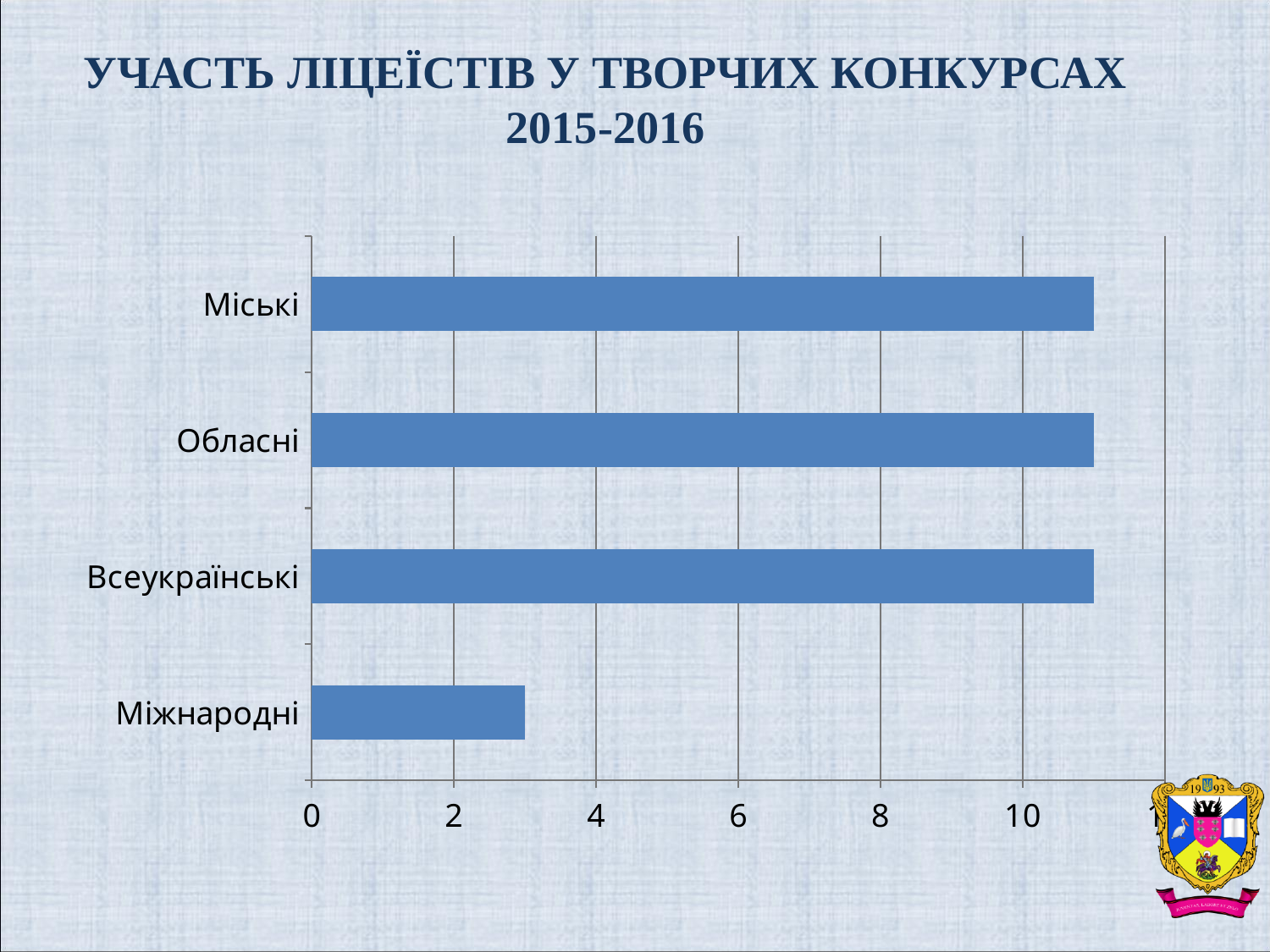
Which is larger, the value for Міські or the value for Міжнародні? Міські Which category has the lowest value in the chart? Міжнародні Is the value for Обласні greater or less than 8? greater How many categories are shown in the chart? 4 What kind of chart is shown on the slide? bar chart What is the title of the chart on the slide? УЧАСТЬ ЛІЦЕЇСТІВ У ТВОРЧИХ КОНКУРСАХ 2015-2016 What colour are the bars in the chart? blue Is the value for Міжнародні greater or less than 2? greater Is the value for Міжнародні greater or less than 4? less Which is larger, the value for Міжнародні or the value for Всеукраїнські? Всеукраїнські